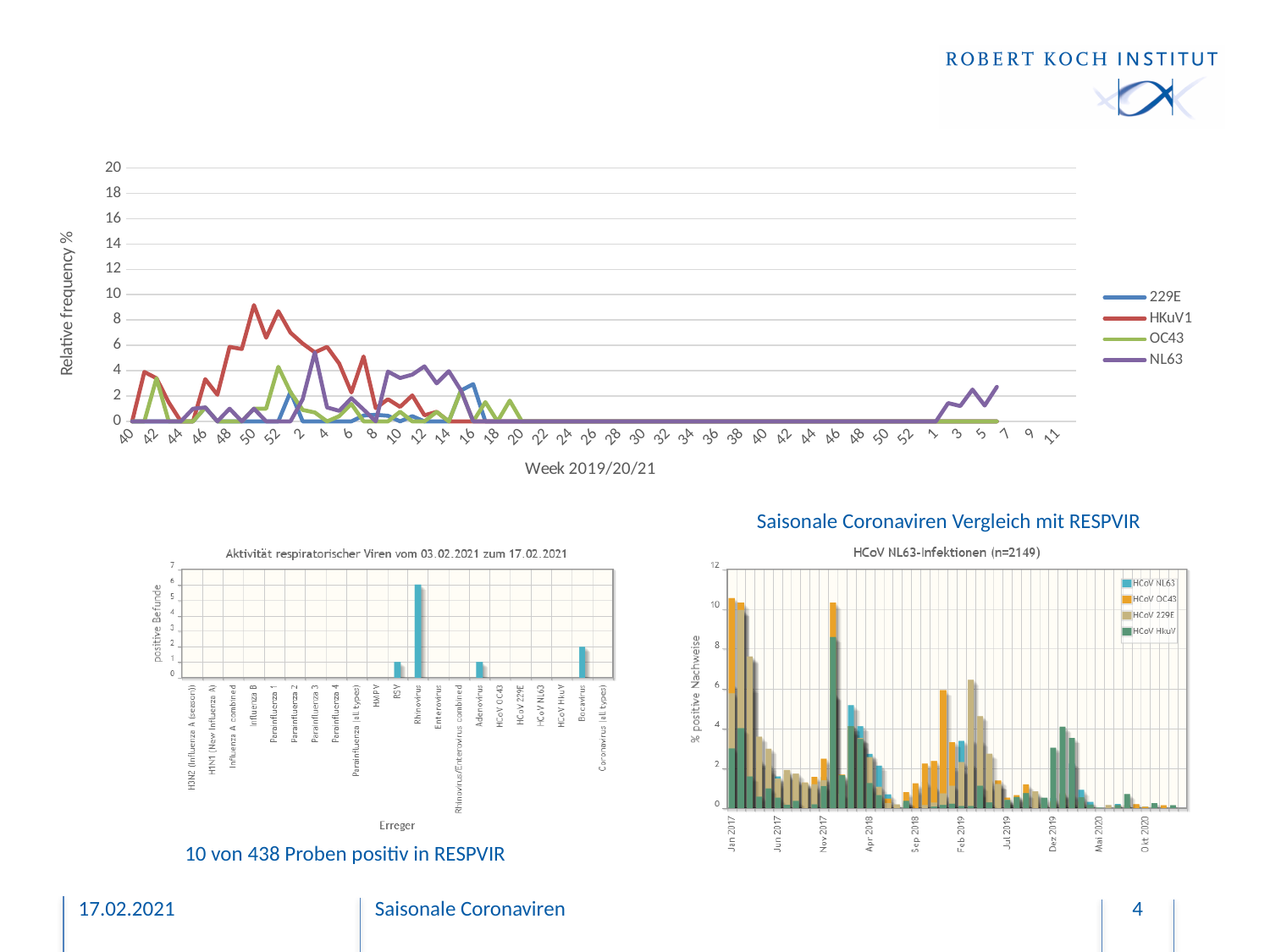
What is the y-axis label of the top chart (Week 2019/20/21)? Relative frequency % How many series does the legend of the bottom-right chart 'HCoV NL63-Infektionen (n=2149)' list? 4 In the bottom-left chart 'Aktivität respiratorischer Viren', what is the difference between the values for Rhinovirus and Bocavirus? 4 How many series does the legend of the top chart (Week 2019/20/21) list? 4 In the top chart (Week 2019/20/21), which series reaches the highest peak? HKuV1 In the bottom-left chart 'Aktivität respiratorischer Viren vom 03.02.2021 zum 17.02.2021', which Erreger has the highest number of positive Befunde? Rhinovirus What kind of chart is the top chart with the x axis labelled 'Week 2019/20/21'? line chart In the top chart (Week 2019/20/21), is the peak value of HKuV1 around week 50 greater or less than 6? greater What kind of chart is the bottom-right chart 'HCoV NL63-Infektionen (n=2149)'? bar chart In the bottom-left chart 'Aktivität respiratorischer Viren', what is the value for Rhinovirus? 6 In the bottom-left chart 'Aktivität respiratorischer Viren', which is larger, the value for Rhinovirus or the value for Adenovirus? Rhinovirus In the bottom-left chart 'Aktivität respiratorischer Viren', what is the value for Bocavirus? 2